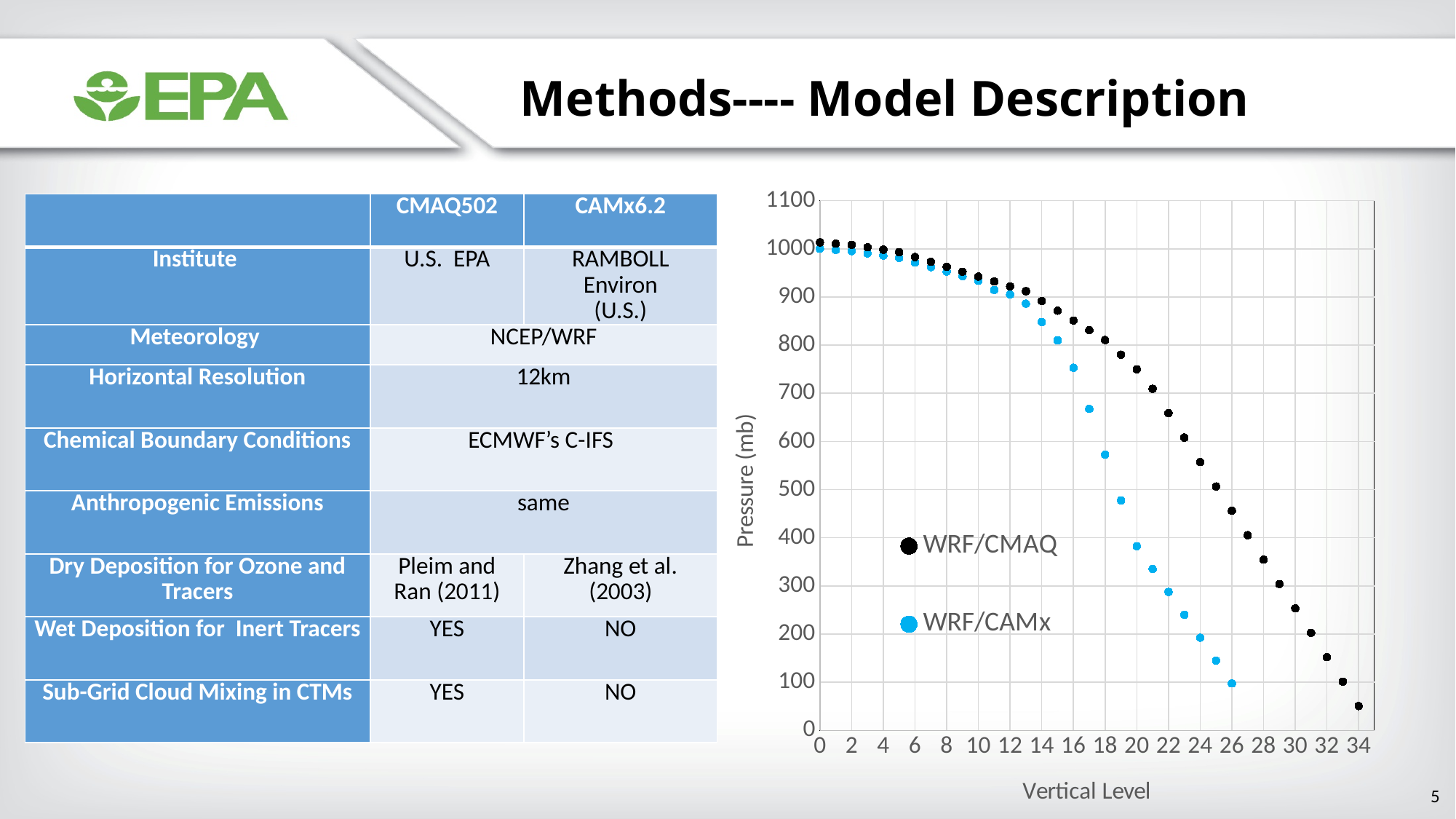
At vertical level 20, which series has the higher pressure, WRF/CMAQ or WRF/CAMx? WRF/CMAQ Is the WRF/CMAQ pressure at vertical level 34 greater or less than 100? less What are the two series named in the chart legend? WRF/CMAQ and WRF/CAMx At which vertical level does the WRF/CMAQ series end? 34 Is the WRF/CAMx pressure at vertical level 18 greater or less than 600? less What kind of chart is shown on the right side of the slide? scatter chart At which vertical level does the WRF/CAMx series end? 26 Which series reaches the lowest pressure value on the chart? WRF/CMAQ How many series does the chart legend list? 2 What is the label of the chart's vertical axis? Pressure (mb) Do the pressure values rise or fall as the vertical level increases? fall